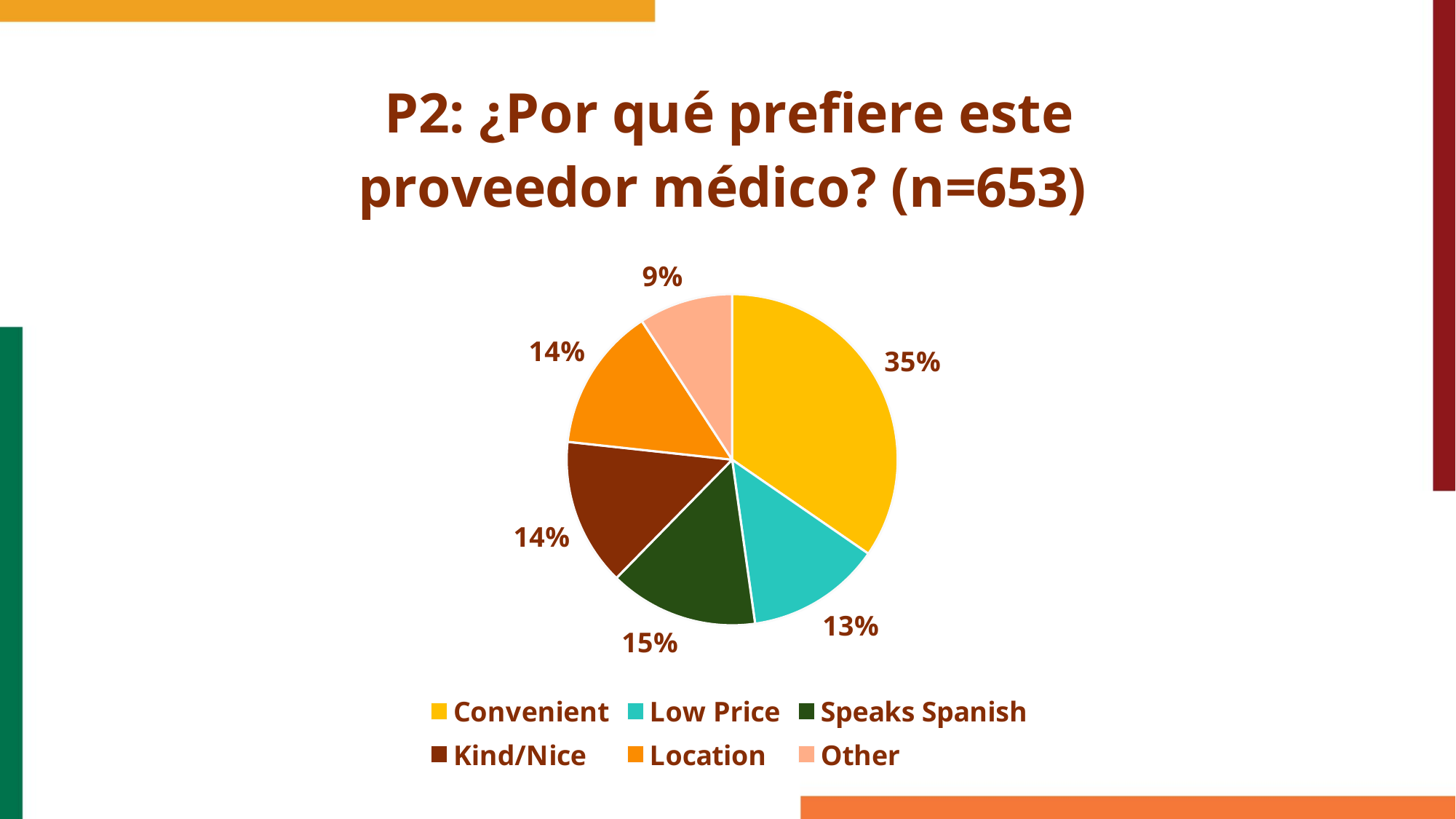
Which is larger, the share for Speaks Spanish or the share for Low Price? Speaks Spanish Which category has the largest slice of the pie? Convenient What share of the pie does Other represent? 9% What is the sample size (n) given in the chart title? 653 What share of the pie does Convenient represent? 35% Which colour represents Location in the legend? orange What share of the pie does Low Price represent? 13% How many categories does the pie chart have? 6 What is the difference in percentage points between Convenient and Low Price? 22 Which category has the smallest slice of the pie? Other What type of chart is shown on the slide? pie chart